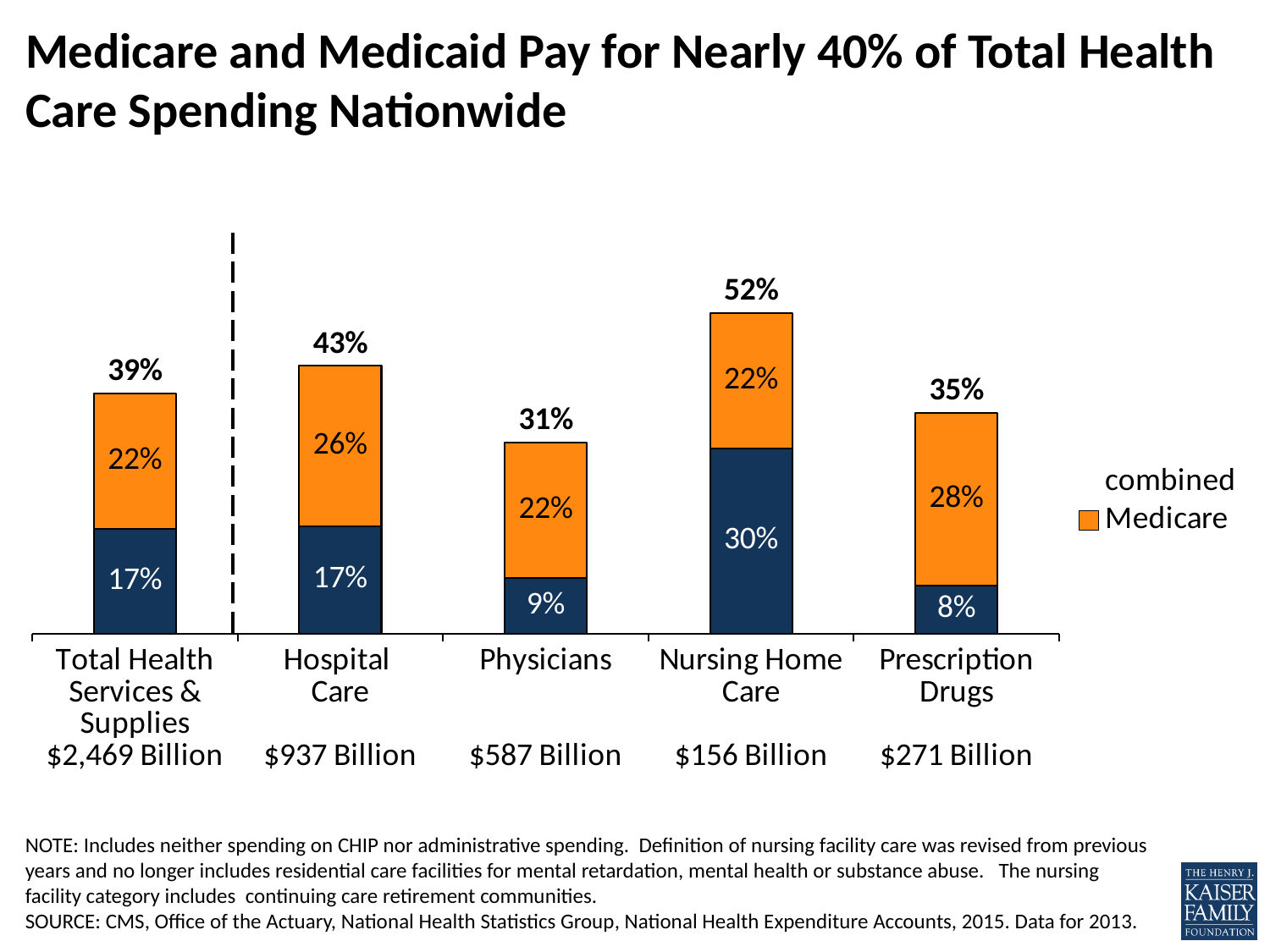
What is the Medicare share of spending for Hospital Care? 26% Which category has the lowest combined percentage? Physicians Which category has the largest dark blue segment? Nursing Home Care What is the value of the dark blue segment for Prescription Drugs? 8% What is the combined percentage shown above the Nursing Home Care bar? 52% Which category has the highest combined percentage? Nursing Home Care What is the difference between the Medicare share for Prescription Drugs and the Medicare share for Physicians? 6 percentage points What total spending amount is shown beneath the Hospital Care category? $937 Billion Which series is shown in orange according to the legend? Medicare What kind of chart is shown on the slide? Stacked bar chart Is the Medicare segment larger for Hospital Care or for Nursing Home Care? Hospital Care How many spending categories are shown on the x axis? 5